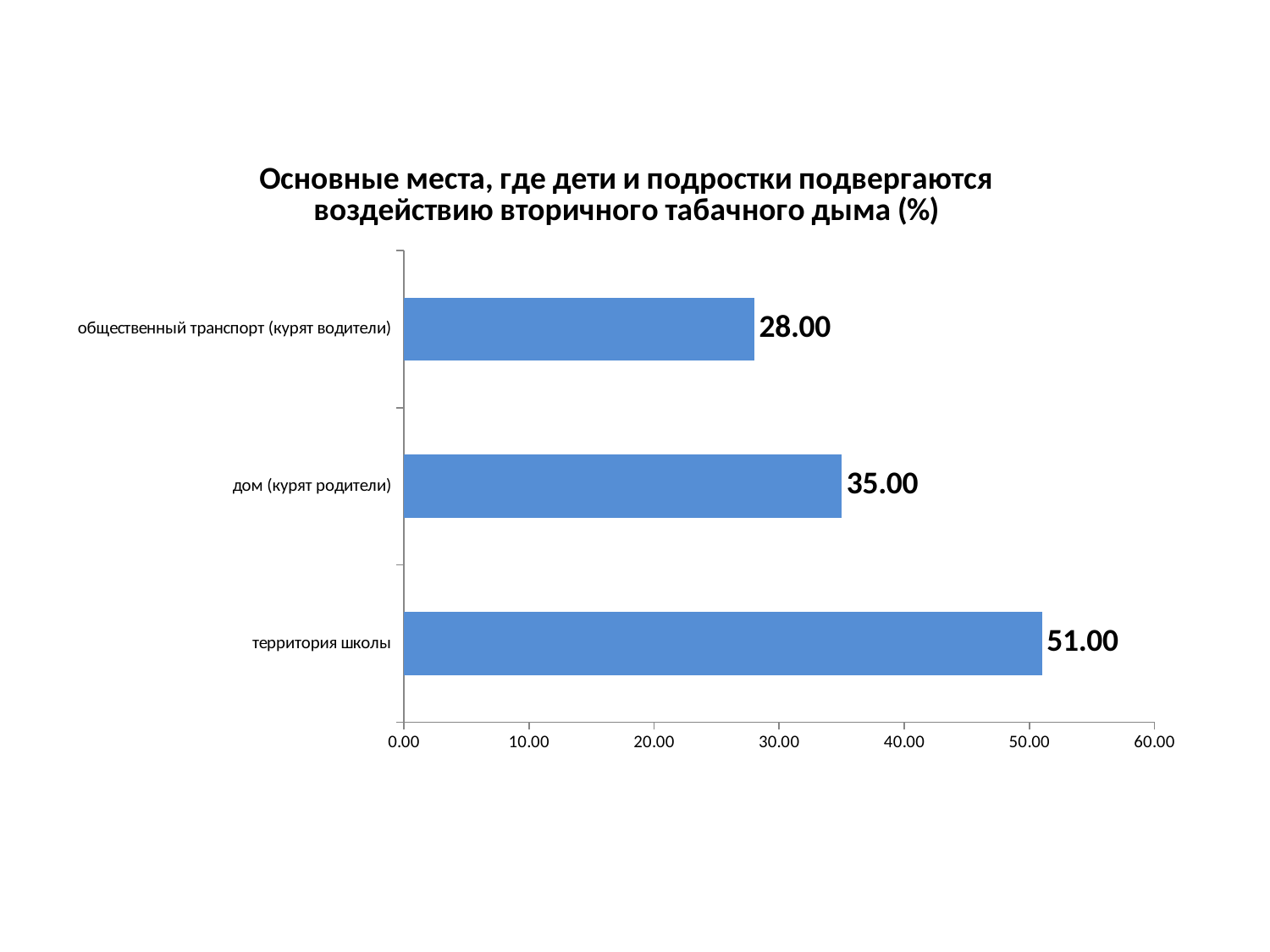
How many categories are shown in the chart? 3 Which category has the lowest value? общественный транспорт (курят водители) What kind of chart is shown on the slide? bar chart What is the value for территория школы? 51.00 What is the value for дом (курят родители)? 35.00 Is the value for территория школы greater or less than 40.00? greater Which category has the highest value? территория школы What is the value for общественный транспорт (курят водители)? 28.00 What is the difference between the values for территория школы and дом (курят родители)? 16.00 Which is larger, the value for дом (курят родители) or the value for общественный транспорт (курят водители)? дом (курят родители) What is the title of the chart? Основные места, где дети и подростки подвергаются воздействию вторичного табачного дыма (%) What is the difference between the values for дом (курят родители) and общественный транспорт (курят водители)? 7.00